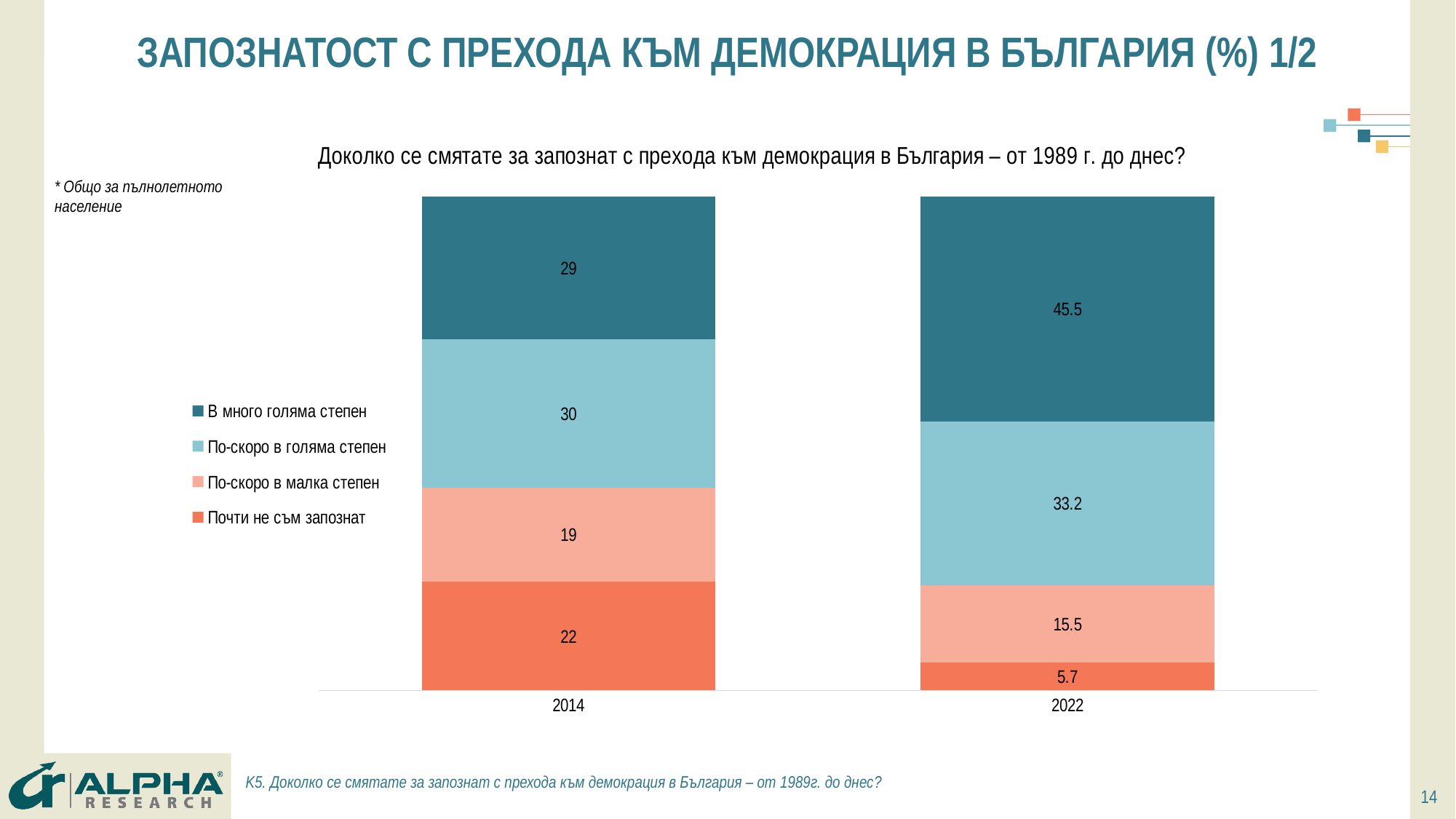
What kind of chart is shown on the slide? Stacked bar chart What is the value for "В много голяма степен" in 2022? 45.5 Which response category has the highest value in 2014? По-скоро в голяма степен What is the difference between the "В много голяма степен" values for 2022 and 2014? 16.5 How many years (categories) are shown on the x axis? 2 What is the value for "По-скоро в голяма степен" in 2022? 33.2 What is the total of the stacked bar for 2014? 100 What is the value for "Почти не съм запознат" in 2014? 22 What is the value for "По-скоро в малка степен" in 2014? 19 Which response category has the lowest value in 2022? Почти не съм запознат Which is larger: "Почти не съм запознат" in 2014 or in 2022? 2014 How many series does the legend list? 4